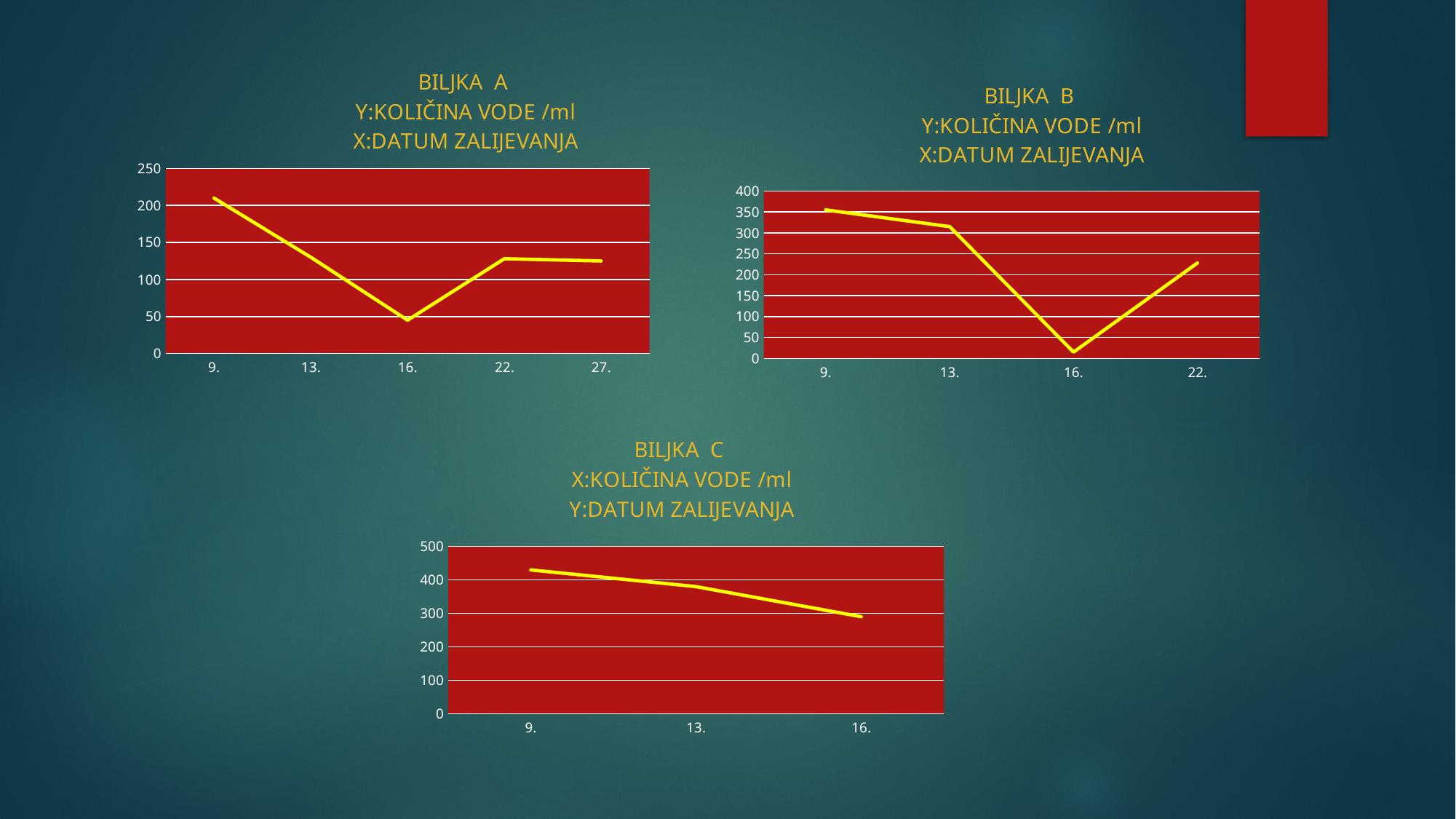
In the BILJKA A chart, on which date is the value lowest? 16. In the BILJKA A chart, is the value for 9. greater or less than 200? greater In the BILJKA A chart, is the value for 16. greater or less than 100? less In the BILJKA C chart, is the value for 9. greater or less than 400? greater In the BILJKA C chart, which date has the larger value, 13. or 16.? 13. In the BILJKA C chart, do the values rise or fall from 9. to 16.? fall How many dates are labelled on the x axis of the BILJKA B chart? 4 In the BILJKA B chart, on which date is the value lowest? 16. In the BILJKA B chart, on which date is the value highest? 9. What kind of chart is BILJKA A? line chart How many dates are labelled on the x axis of the BILJKA A chart? 5